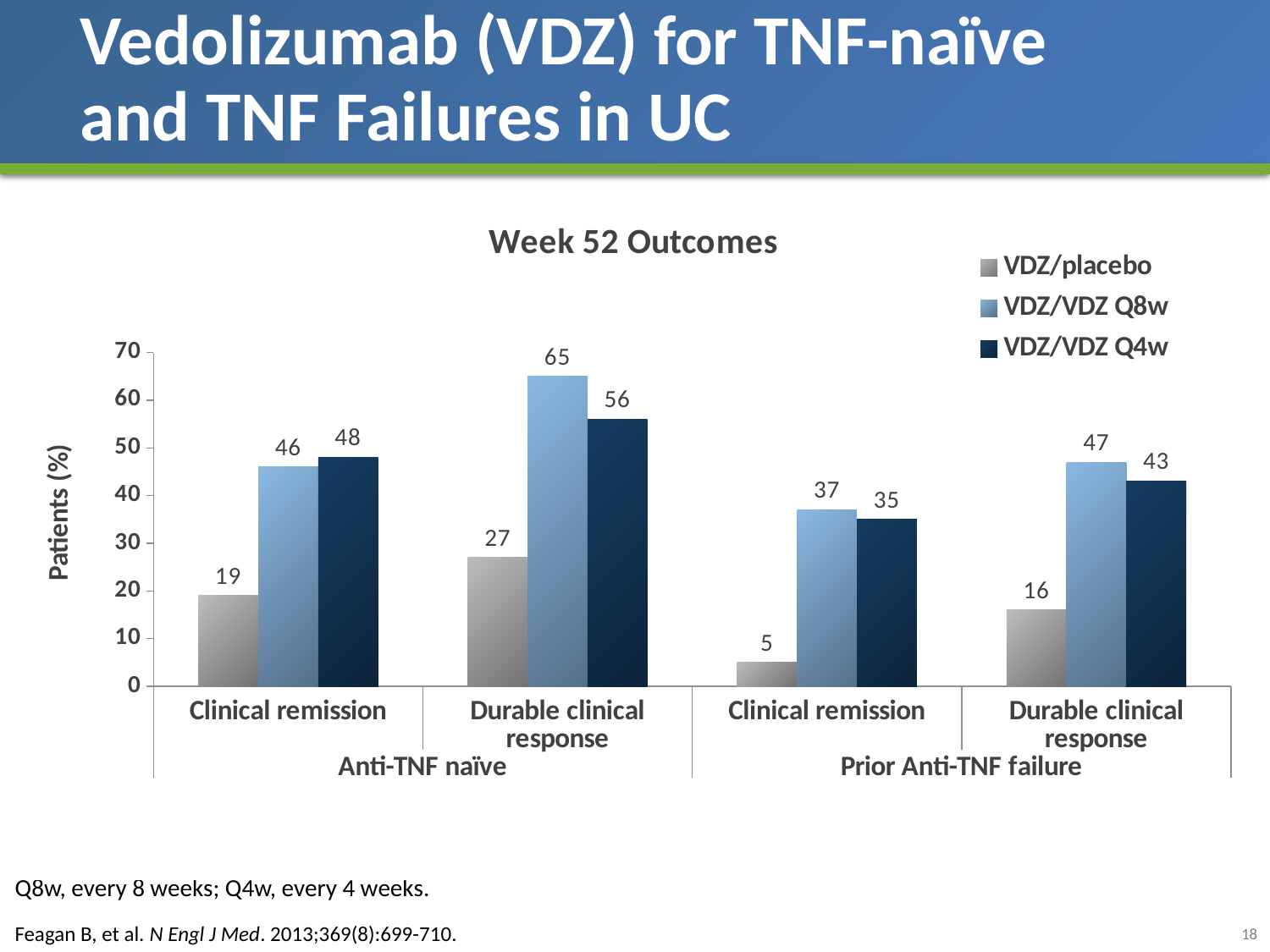
Which series has the lowest value in Clinical remission among Prior Anti-TNF failure patients? VDZ/placebo Which is larger: VDZ/VDZ Q8w in Durable clinical response for Prior Anti-TNF failure, or VDZ/VDZ Q4w in the same category? VDZ/VDZ Q8w Which series has the highest value in Durable clinical response among Anti-TNF naïve patients? VDZ/VDZ Q8w How many outcome categories are shown on the x axis? 4 What is the title of the chart? Week 52 Outcomes How many series does the legend list? 3 What is the value for VDZ/VDZ Q8w in Durable clinical response among Anti-TNF naïve patients? 65 What is the value for VDZ/VDZ Q4w in Clinical remission among Prior Anti-TNF failure patients? 35 What is the value for VDZ/placebo in Clinical remission among Anti-TNF naïve patients? 19 What kind of chart is shown on the slide? Bar chart What is the difference between VDZ/VDZ Q8w and VDZ/placebo in Clinical remission among Anti-TNF naïve patients? 27 What is the value for VDZ/placebo in Durable clinical response among Prior Anti-TNF failure patients? 16